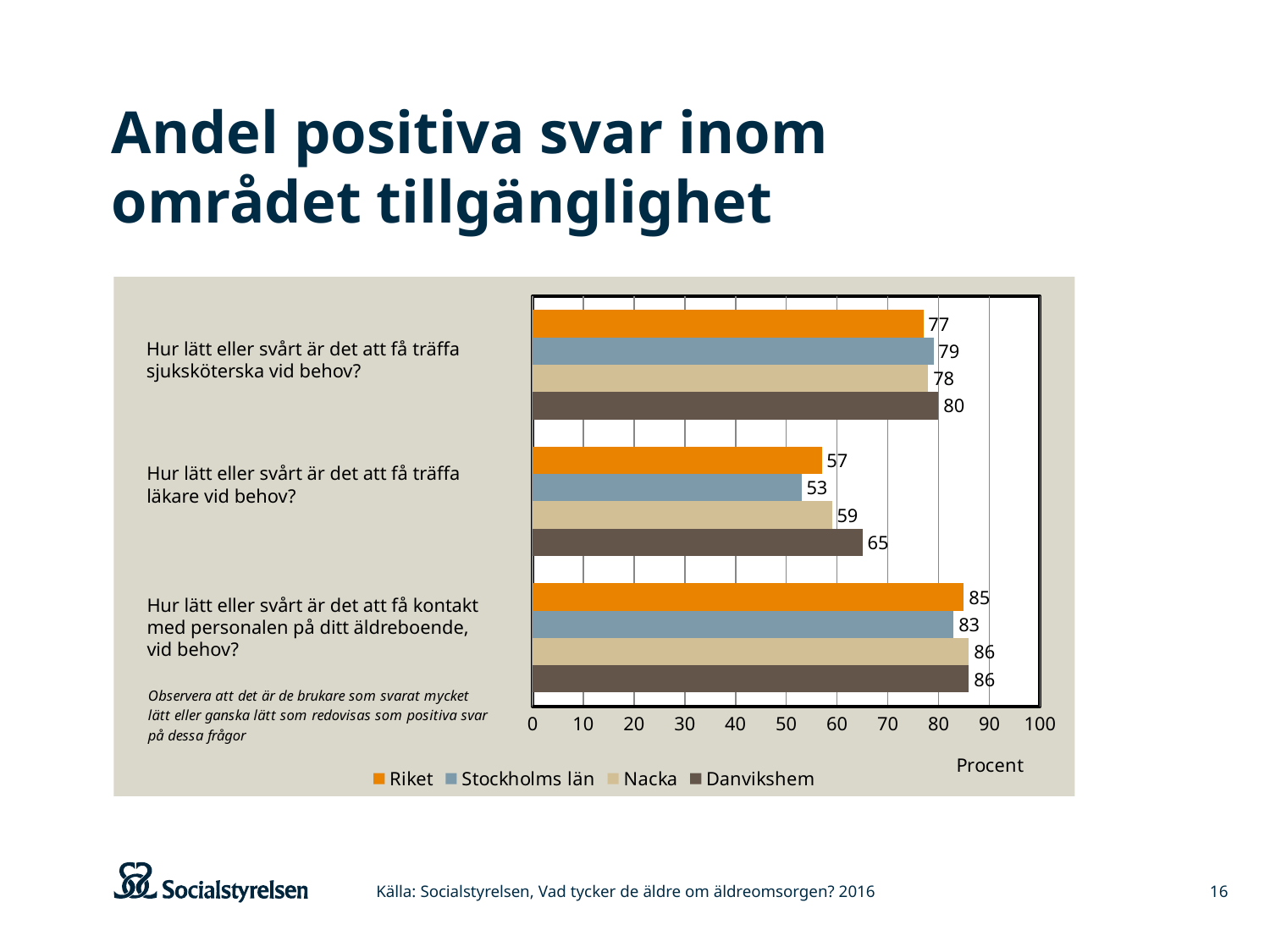
How many questions (categories) are shown on the chart? 3 What value is shown for Stockholms län on the question "Hur lätt eller svårt är det att få kontakt med personalen på ditt äldreboende, vid behov?" 83 What is the difference between the Danvikshem and Riket values on the question "Hur lätt eller svårt är det att få träffa läkare vid behov?" 8 Which series has the lowest value on the question "Hur lätt eller svårt är det att få träffa läkare vid behov?" Stockholms län What unit label is shown on the horizontal axis of the chart? Procent On the question "Hur lätt eller svårt är det att få kontakt med personalen på ditt äldreboende, vid behov?", which is larger: the value for Riket or for Stockholms län? Riket How many series does the legend list? 4 What value is shown for Danvikshem on the question "Hur lätt eller svårt är det att få träffa läkare vid behov?" 65 What kind of chart is shown on the slide? Bar chart What value is shown for Riket on the question "Hur lätt eller svårt är det att få träffa sjuksköterska vid behov?" 77 Which series has the highest value on the question "Hur lätt eller svårt är det att få träffa sjuksköterska vid behov?" Danvikshem Is the value for Nacka on the question "Hur lätt eller svårt är det att få träffa läkare vid behov?" greater or less than 60? less